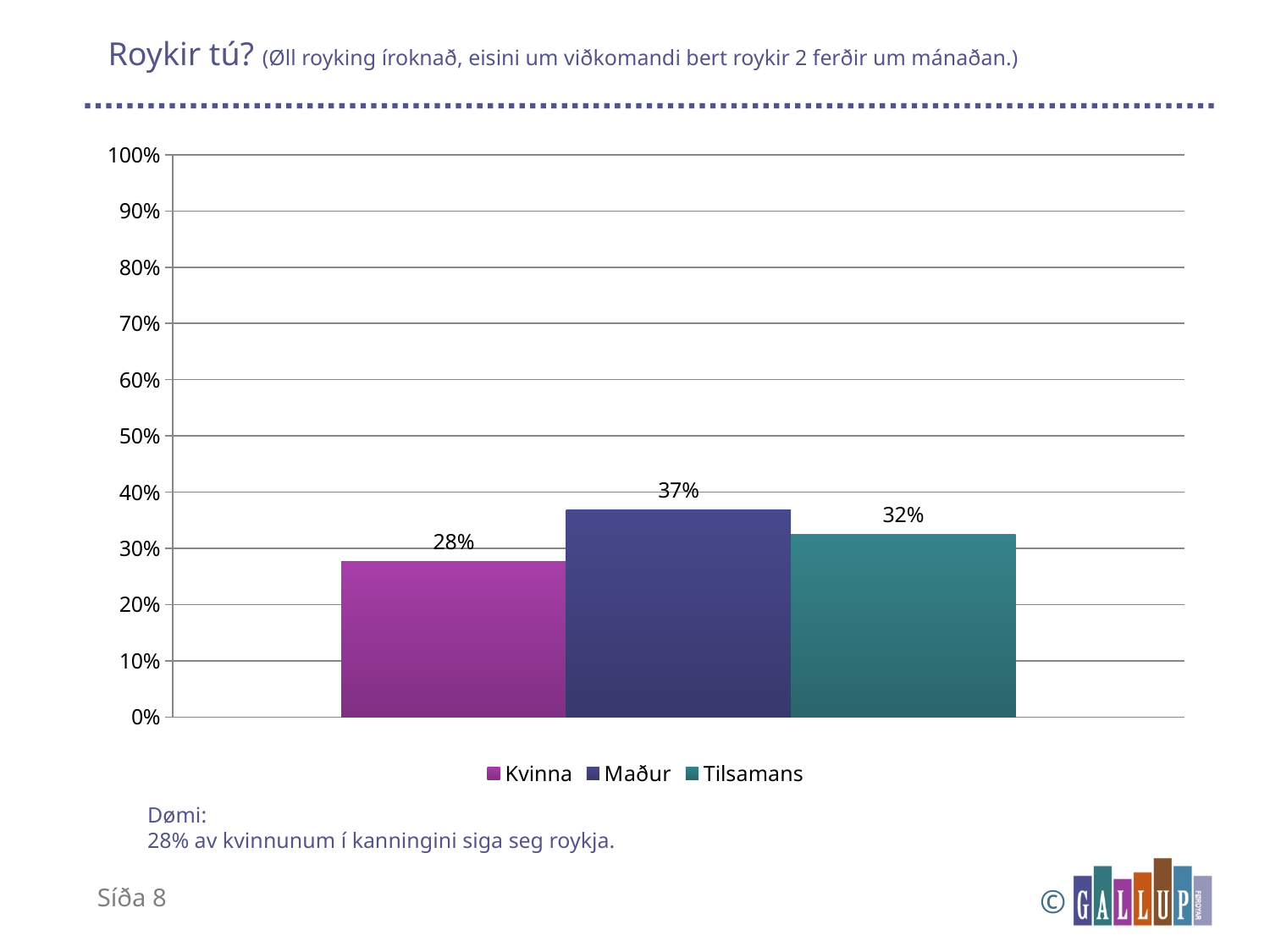
What is the difference between the values for Tilsamans and Kvinna? 4% What is the value for Maður? 37% What kind of chart is shown on the slide? bar chart What is the value for Tilsamans? 32% What is the difference between the values for Maður and Kvinna? 9% What is the value for Kvinna? 28% How many series does the legend list? 3 Which is larger, the value for Maður or the value for Tilsamans? Maður Is the value for Maður greater or less than 40%? less Which series has the lowest value? Kvinna Which series has the highest value? Maður What is the highest value shown on the vertical axis? 100%